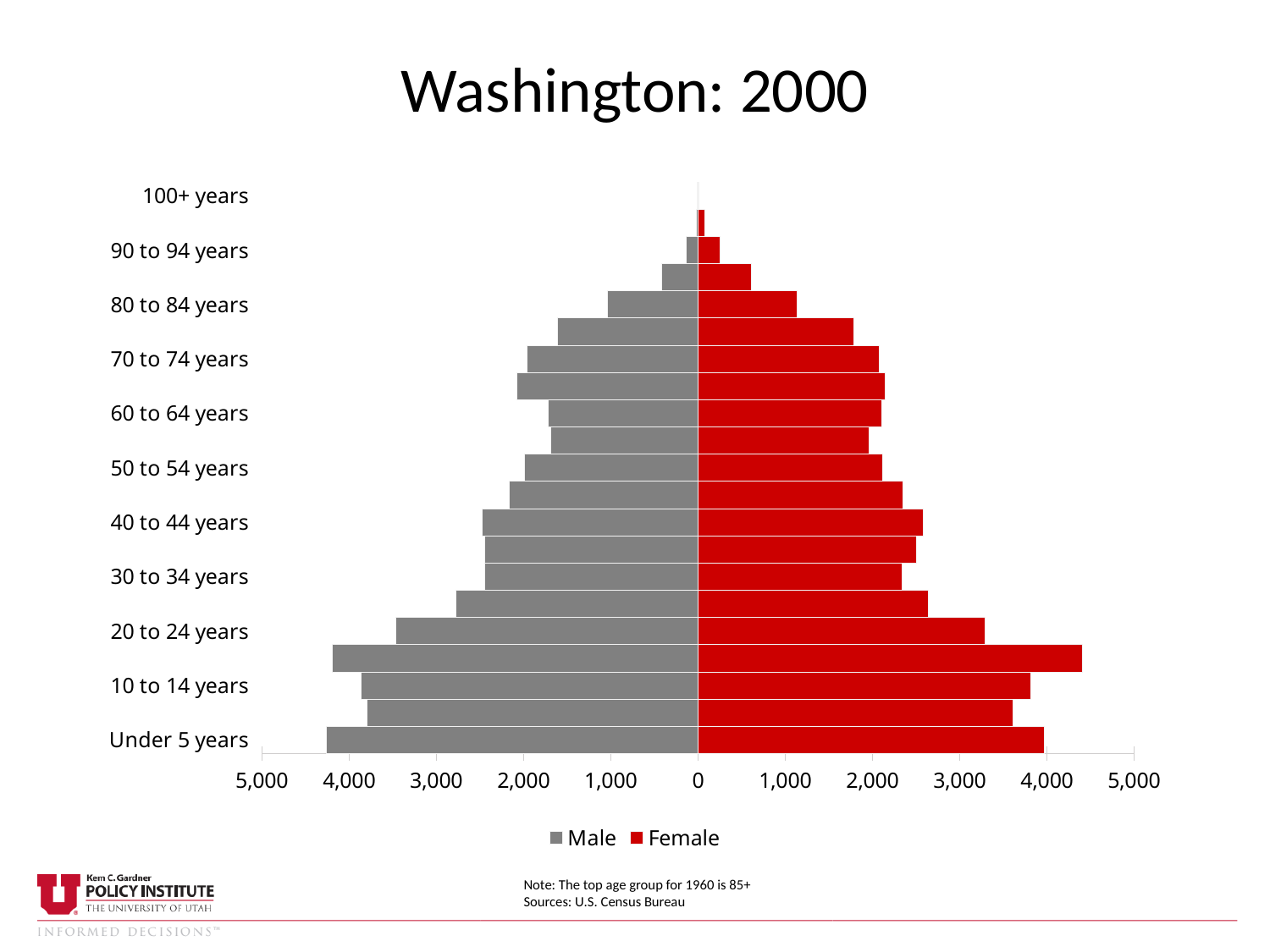
For the 90 to 94 years group, which is larger, the Male or the Female value? Female Is the Female value for 40 to 44 years greater or less than 2,000? greater What kind of chart is shown on the slide? Bar chart Is the Male value for Under 5 years greater or less than 4,000? greater What is the title of the chart? Washington: 2000 How many series does the legend list? 2 Is the Male value for 20 to 24 years greater or less than 3,000? greater For the 60 to 64 years group, which is larger, the Male or the Female value? Female Which colour represents the Female series in the chart? Red